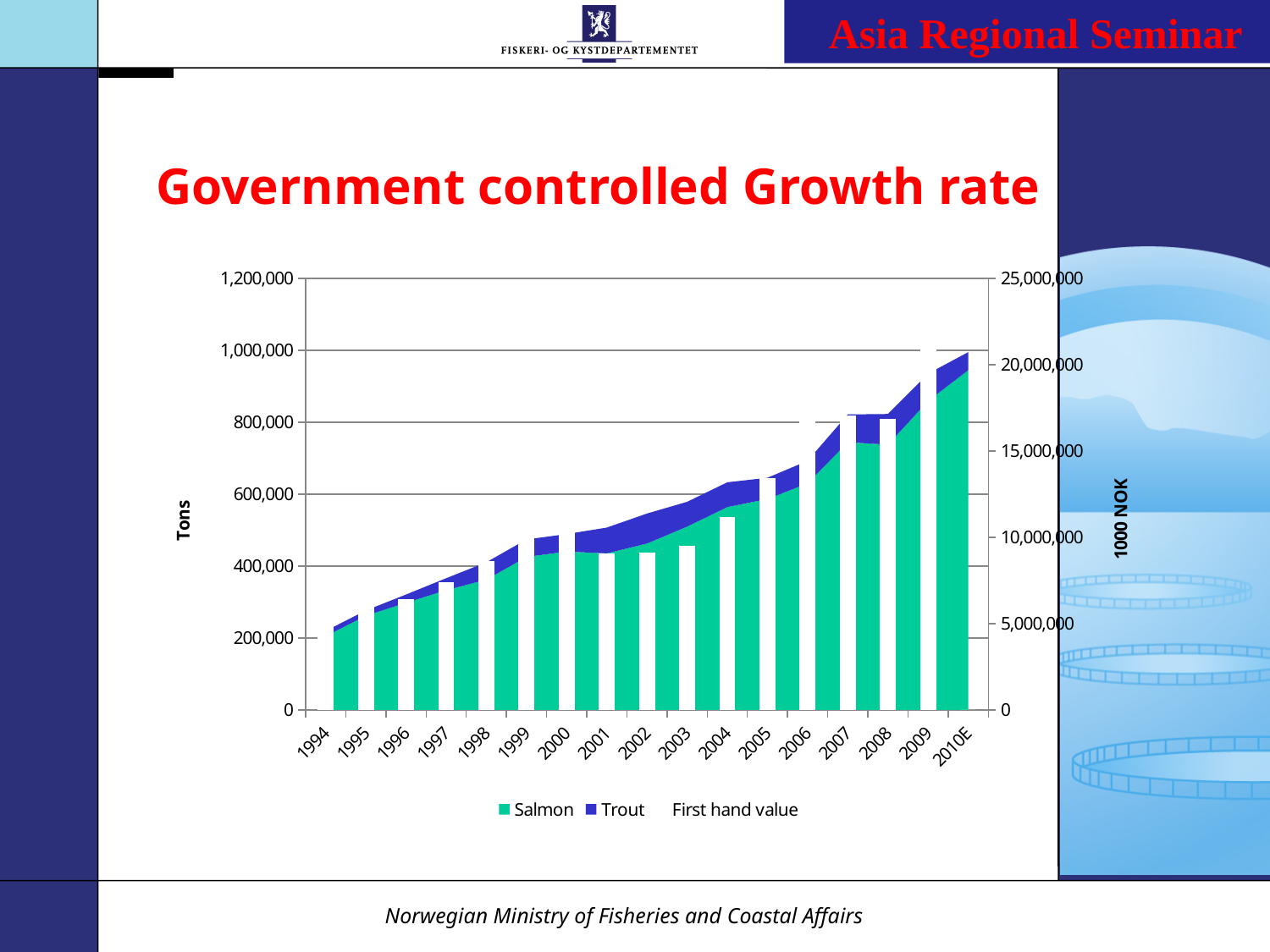
Which year has the highest Salmon value? 2010E Is the Salmon value for 1994 greater or less than 400,000 tons? less How many series does the chart legend list? 3 Which series are listed in the chart legend? Salmon, Trout, First hand value Is the Salmon value for 2010E greater or less than 800,000 tons? greater What is the title of the chart? Government controlled Growth rate Does the Salmon production rise or fall from 1994 to 2010E? Rise What kind of chart is shown on the slide? Combination of stacked area and bar chart How many years are shown along the x axis of the chart? 17 Is the First hand value for 2004 greater or less than 10,000,000 (1000 NOK)? greater